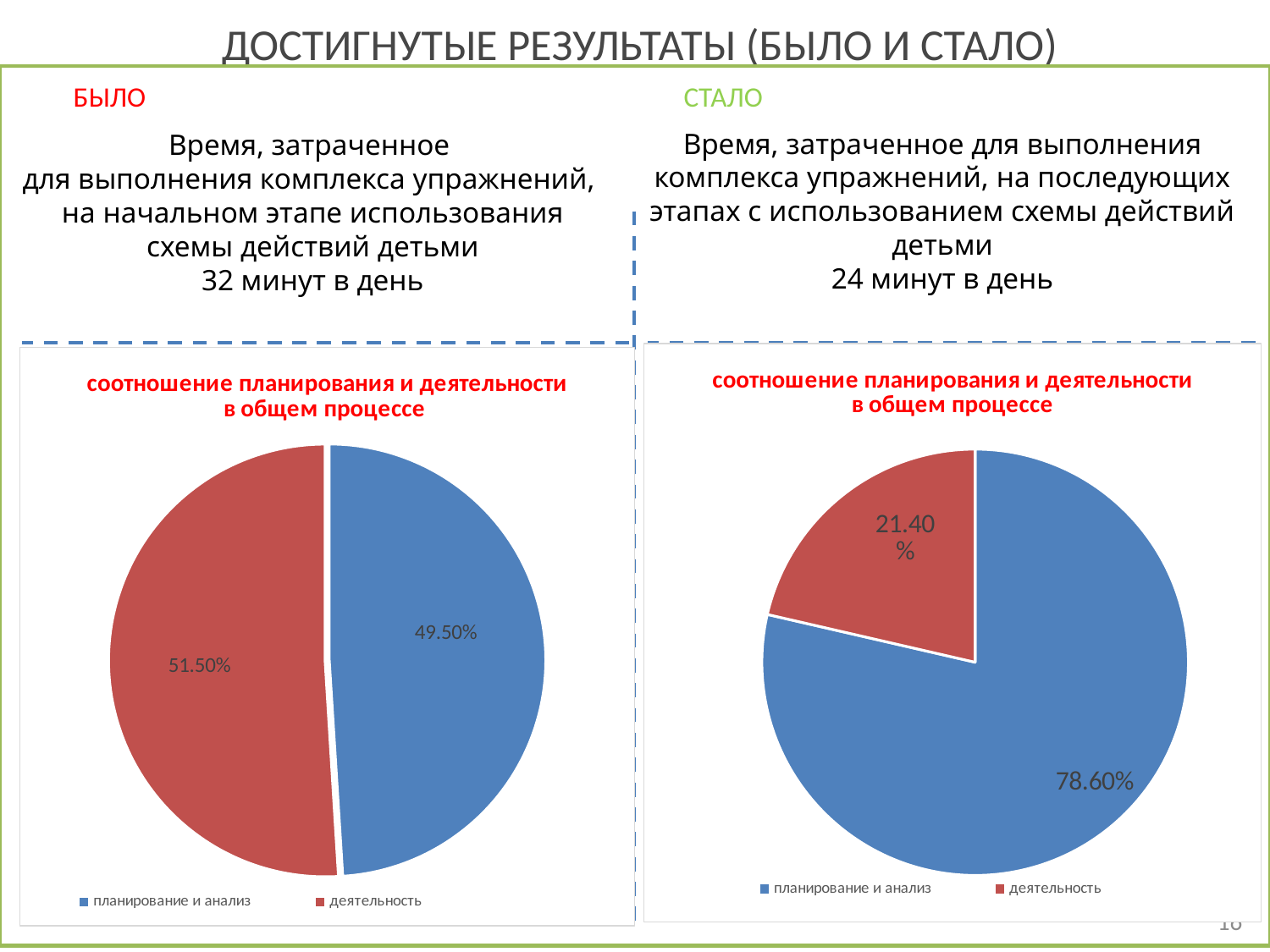
In the left pie chart (БЫЛО), what is the difference between the деятельность share and the планирование и анализ share? 2.00% In the right pie chart (СТАЛО), what is the difference between the планирование и анализ share and the деятельность share? 57.20% In the left pie chart (БЫЛО), what is the share for деятельность? 51.50% What type of chart is shown on the left side of the slide (БЫЛО)? Pie chart How many slices does the right pie chart (СТАЛО) have? 2 In the right pie chart (СТАЛО), what is the share for деятельность? 21.40% In the right pie chart (СТАЛО), which is larger: планирование и анализ or деятельность? планирование и анализ In the right pie chart (СТАЛО), which slice is the largest? планирование и анализ In the right pie chart (СТАЛО), what is the share for планирование и анализ? 78.60% In the right pie chart (СТАЛО), which slice is the smallest? деятельность What colour is the деятельность slice in the left pie chart (БЫЛО)? Red In the left pie chart (БЫЛО), what is the share for планирование и анализ? 49.50%